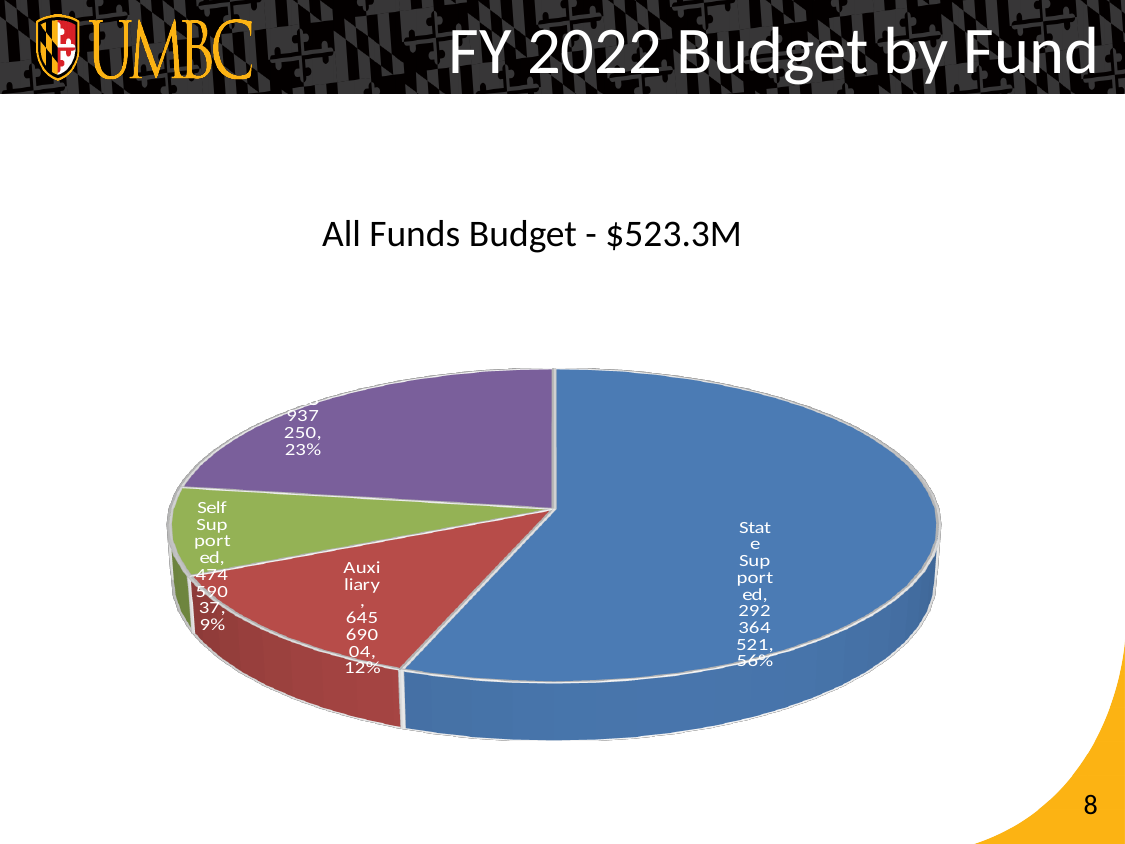
What total budget amount is stated in the chart title? $523.3M What is the title of the chart? All Funds Budget - $523.3M What share of the pie does Auxiliary represent? 12% What share of the pie does Self Supported represent? 9% What is the difference in percentage points between the State Supported share and the Auxiliary share? 44% How many slices does the pie chart have? 4 What percentage is shown on the purple slice of the pie? 23% What kind of chart is shown on the slide? Pie chart Which fund category has the smallest slice of the pie? Self Supported Which is larger, the Auxiliary share or the Self Supported share? Auxiliary Which fund category has the largest slice of the pie? State Supported